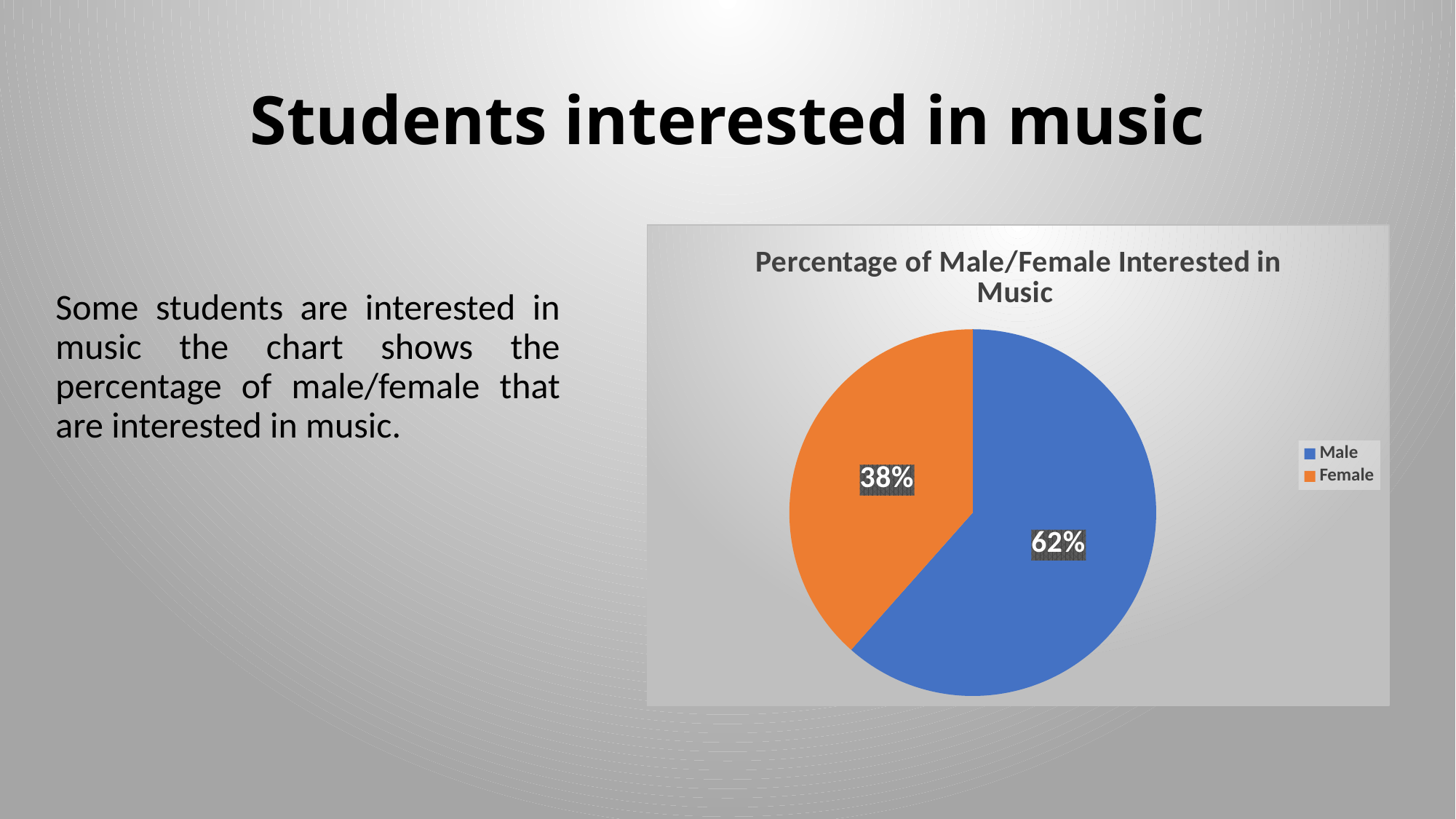
Which slice is the smallest in the pie chart? Female What percentage of the pie is the Female slice? 38% Which slice is the largest in the pie chart? Male Which is larger, the Male slice or the Female slice? Male What colour is the Female slice in the pie chart? orange What share of the pie does the Male slice represent? 62% What is the title of the chart? Percentage of Male/Female Interested in Music What is the difference in percentage points between the Male and Female slices? 24 What kind of chart is shown on the slide? pie chart How many entries does the legend list? 2 How many slices does the pie chart have? 2 What percentage of the pie is the Male slice? 62%